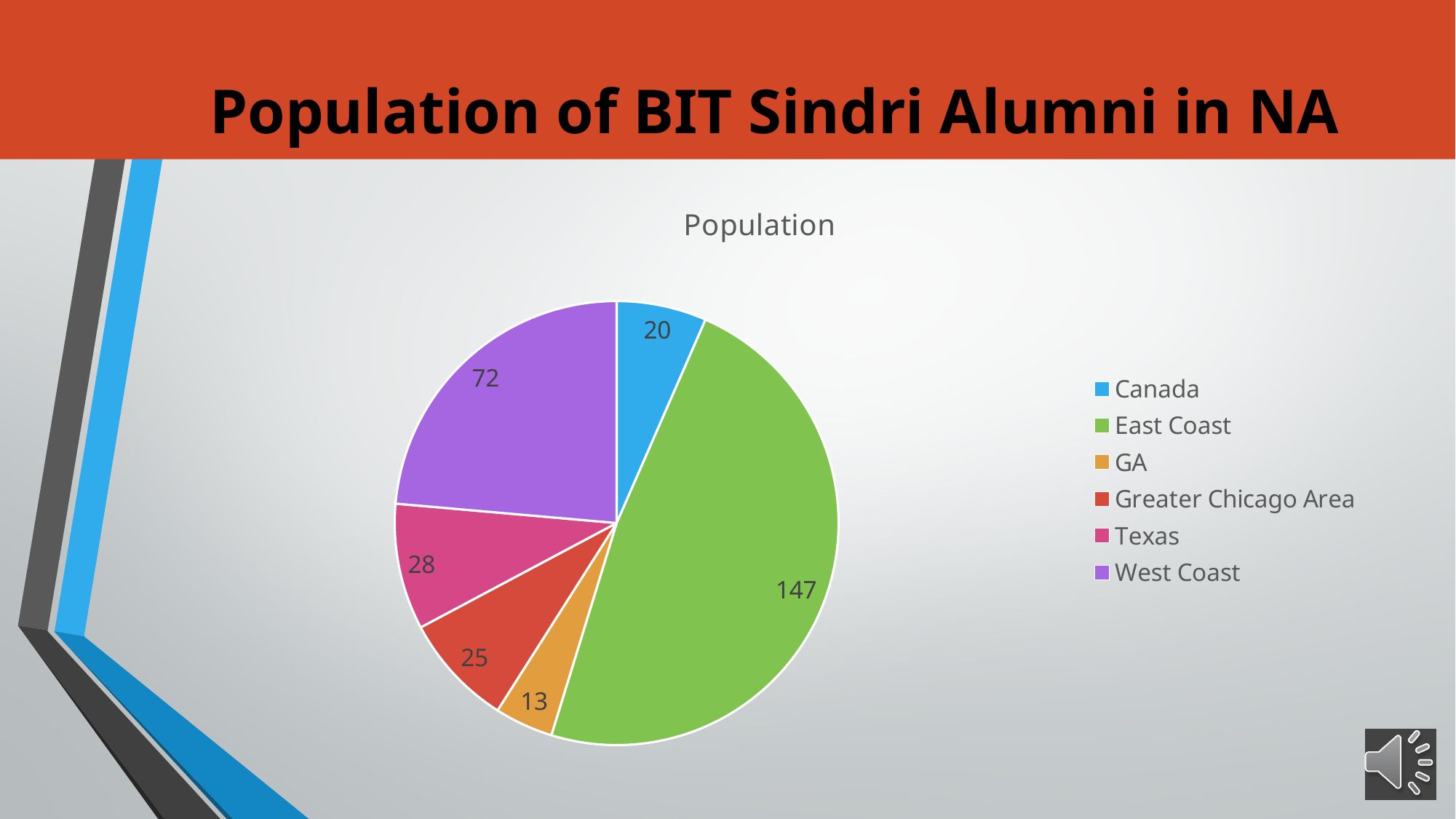
What is the value for East Coast? 147 Which region has the smallest slice of the pie? GA What is the total of all the slices in the pie chart? 305 Which region has the largest slice of the pie? East Coast What is the value for West Coast? 72 How many regions are shown in the pie chart? 6 What is the value for Canada? 20 Which is larger, the value for Texas or the value for Greater Chicago Area? Texas What is the difference between the East Coast and West Coast values? 75 What is the title of the chart? Population What type of chart is shown on the slide? Pie chart What is the value for GA? 13